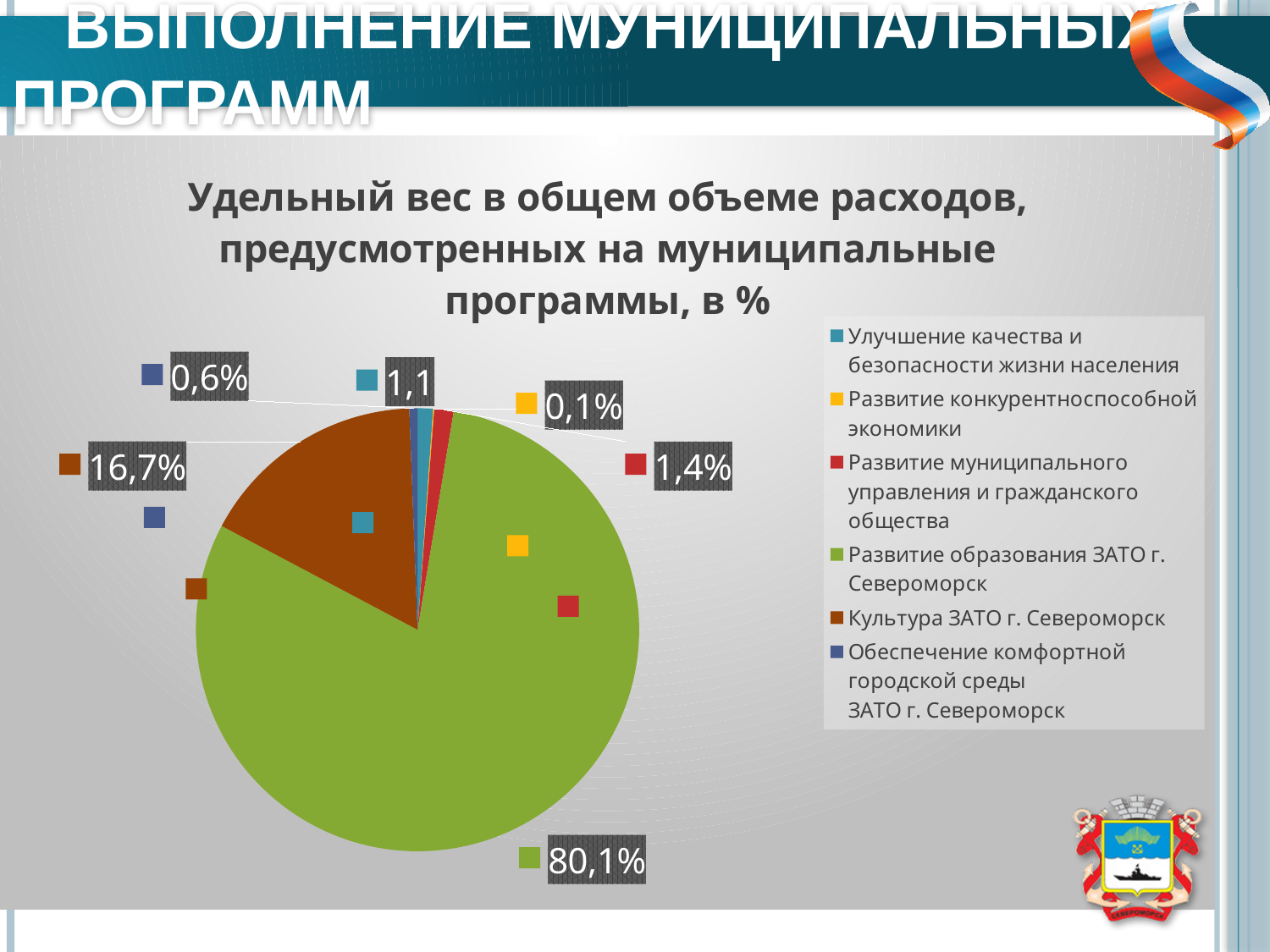
What is the share for "Развитие муниципального управления и гражданского общества"? 1,4% What is the share for "Развитие образования ЗАТО г. Североморск"? 80,1% What is the share for "Обеспечение комфортной городской среды ЗАТО г. Североморск"? 0,6% What kind of chart is shown on the slide? pie chart What is the share for "Культура ЗАТО г. Североморск"? 16,7% What is the difference between the shares for "Развитие образования ЗАТО г. Североморск" and "Культура ЗАТО г. Североморск"? 63,4% What is the share for "Развитие конкурентноспособной экономики"? 0,1% Which is larger: the share for "Развитие муниципального управления и гражданского общества" or for "Обеспечение комфортной городской среды ЗАТО г. Североморск"? Развитие муниципального управления и гражданского общества Which category has the smallest slice of the pie? Развитие конкурентноспособной экономики What value is labelled for "Улучшение качества и безопасности жизни населения"? 1,1 Which category has the largest slice of the pie? Развитие образования ЗАТО г. Североморск How many categories does the legend list? 6